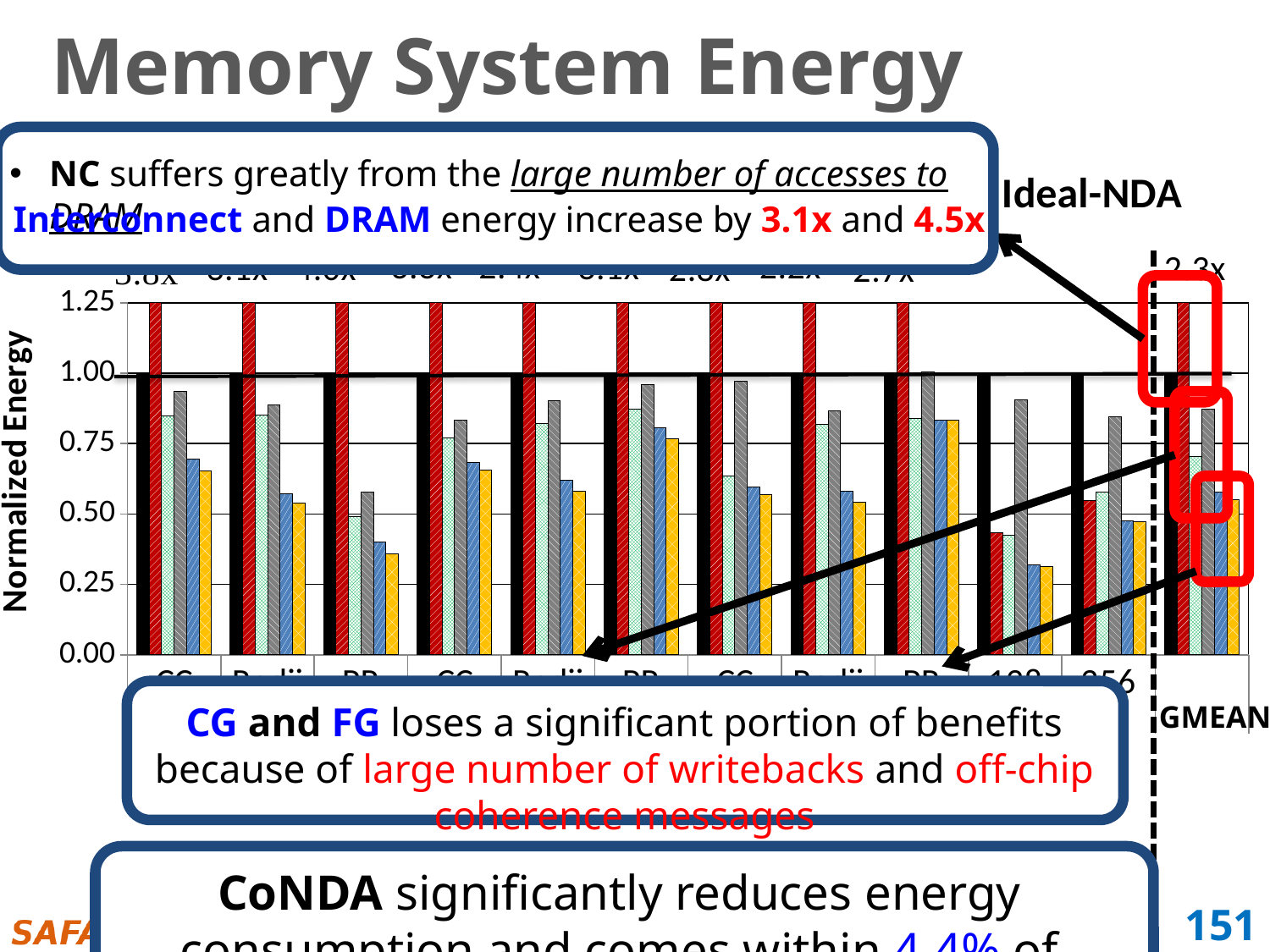
In the GMEAN group, which bar is taller: the red bar or the yellow bar? the red bar Is the value of the red bar for GMEAN greater or less than 1.00? greater What is the label on the vertical axis of the chart? Normalized Energy What is the value of the black bar for GMEAN? 1.00 What kind of chart is shown on the slide? bar chart What multiplier label is printed above the red bar for GMEAN? 2.3x What is the highest tick value shown on the vertical axis? 1.25 Is the value of the yellow bar for GMEAN greater or less than 0.75? less Is the value of the gray bar for GMEAN greater or less than 0.75? greater How many bars are plotted in each category group of the chart? 6